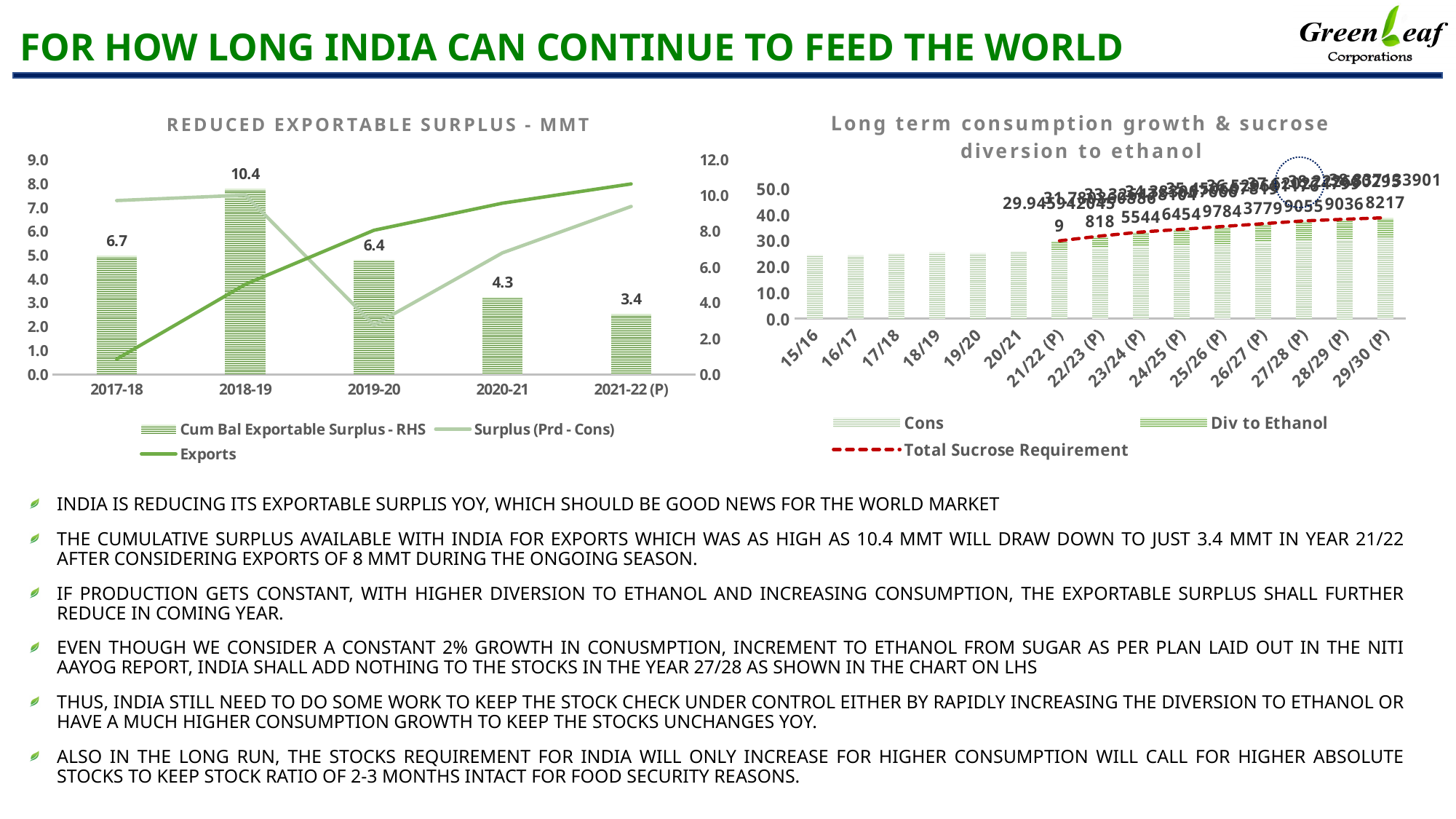
In the 'REDUCED EXPORTABLE SURPLUS - MMT' chart, which year has the larger bar value, 2017-18 or 2019-20? 2017-18 In the 'REDUCED EXPORTABLE SURPLUS - MMT' chart, what is the Cum Bal Exportable Surplus value for 2018-19? 10.4 In the 'REDUCED EXPORTABLE SURPLUS - MMT' chart, does the Exports line rise or fall from 2017-18 to 2021-22 (P)? rises In the 'REDUCED EXPORTABLE SURPLUS - MMT' chart, which year has the lowest bar value? 2021-22 (P) How many periods are shown on the x axis of the 'Long term consumption growth & sucrose diversion to ethanol' chart? 15 How many series does the legend of the 'Long term consumption growth & sucrose diversion to ethanol' chart list? 3 In the 'REDUCED EXPORTABLE SURPLUS - MMT' chart, what is the difference between the bar values for 2018-19 and 2021-22 (P)? 7.0 How many years are shown on the x axis of the 'REDUCED EXPORTABLE SURPLUS - MMT' chart? 5 In the 'REDUCED EXPORTABLE SURPLUS - MMT' chart, which year has the highest bar value? 2018-19 In the 'REDUCED EXPORTABLE SURPLUS - MMT' chart, what is the bar value for 2021-22 (P)? 3.4 How many series does the legend of the 'REDUCED EXPORTABLE SURPLUS - MMT' chart list? 3 In the 'Long term consumption growth & sucrose diversion to ethanol' chart, is the bar value for 15/16 greater or less than 30.0? less